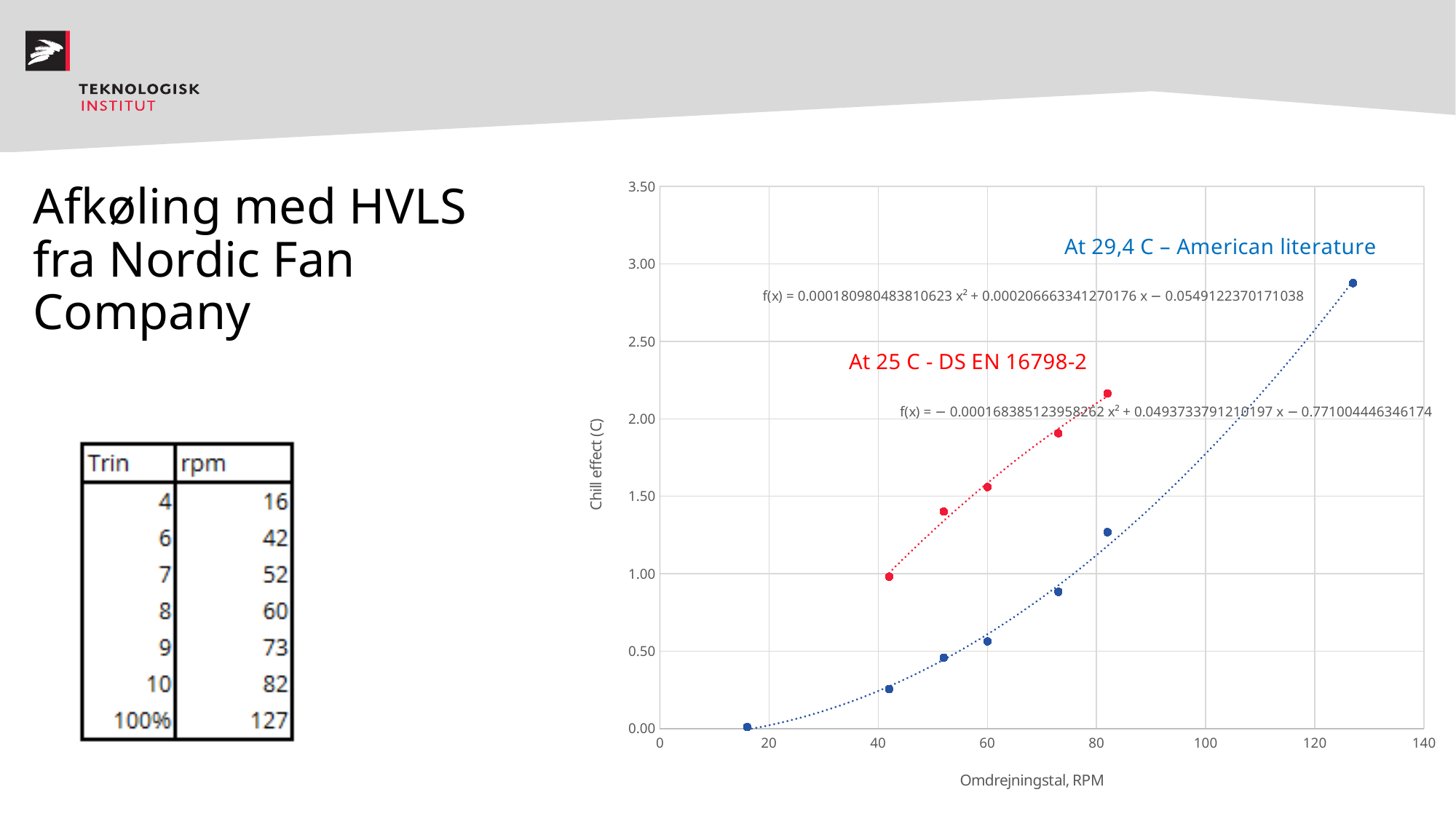
What kind of chart is shown on the slide? scatter chart Is the chill effect of the red series at about 73 RPM greater or less than 1.50? greater How many data points does the blue series (At 29,4 C – American literature) have? 7 At about 60 RPM, which series shows the higher chill effect, the red (At 25 C) or the blue (At 29,4 C)? red (At 25 C) What is the label of the x axis of the chart? Omdrejningstal, RPM What is the label of the y axis of the chart? Chill effect (C) Is the chill effect of the red series at about 82 RPM greater or less than 2.00? greater How many data series are plotted on the chart? 2 Does the chill effect rise or fall as RPM increases along the x axis? rise Is the chill effect of the blue series at about 127 RPM greater or less than 2.50? greater How many data points does the red series (At 25 C - DS EN 16798-2) have? 5